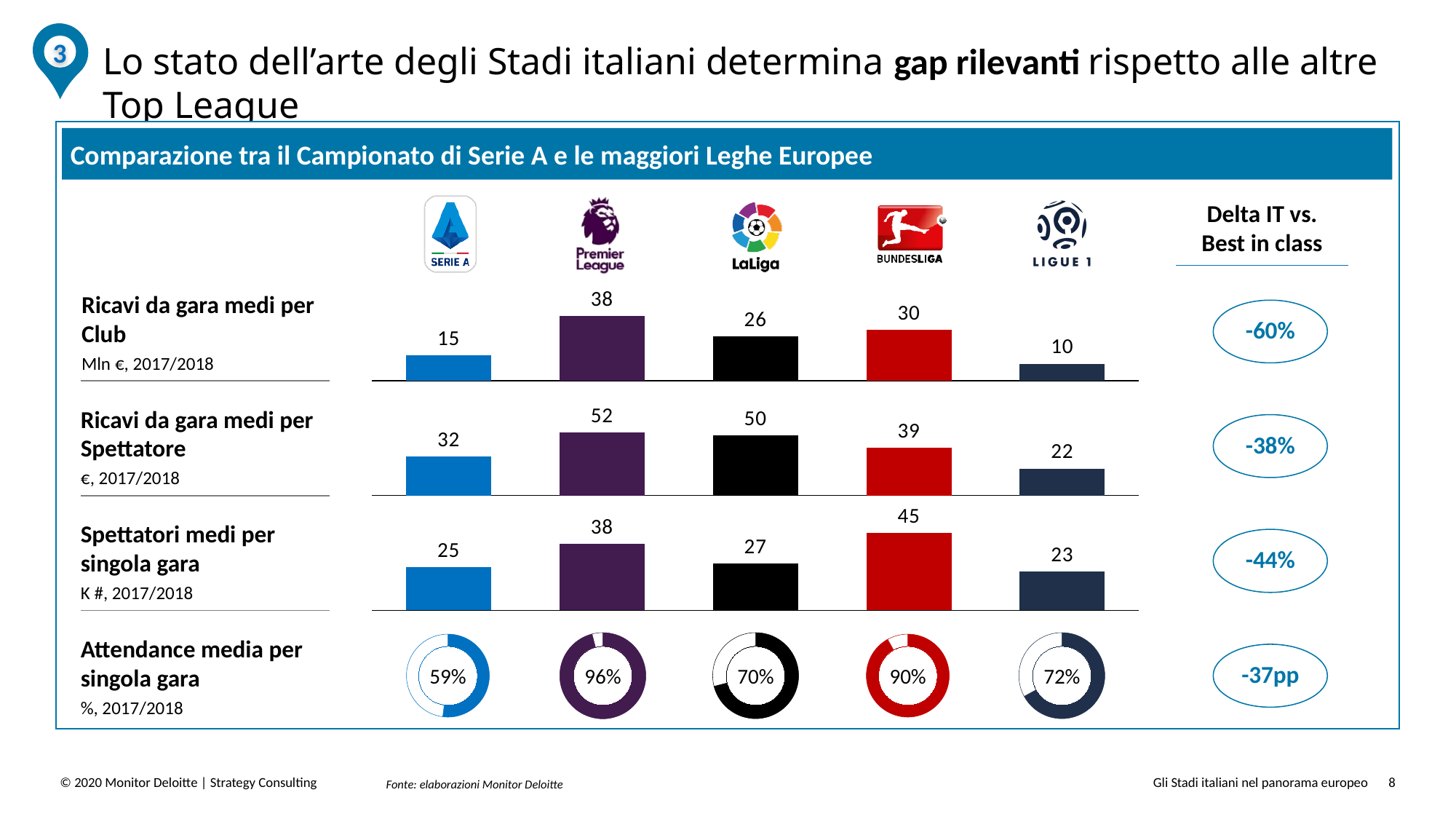
In the 'Ricavi da gara medi per Spettatore' chart, which league has the highest value? Premier League In the 'Ricavi da gara medi per Spettatore' chart, what is the value for Serie A? 32 In the 'Ricavi da gara medi per Club' chart, what is the value for Premier League? 38 In the 'Attendance media per singola gara' chart, what is the value for Bundesliga? 90% How many leagues are compared in the 'Ricavi da gara medi per Club' chart? 5 In the 'Attendance media per singola gara' chart, which league has the lowest attendance? Serie A In the 'Ricavi da gara medi per Club' chart, which league has the lowest value? Ligue 1 In the 'Spettatori medi per singola gara' chart, which is larger, Serie A or Ligue 1? Serie A In the 'Ricavi da gara medi per Spettatore' chart, what is the difference between Premier League and Serie A? 20 In the 'Spettatori medi per singola gara' chart, what is the value for LaLiga? 27 In the 'Spettatori medi per singola gara' chart, which league has the highest value? Bundesliga What kind of chart is used for the 'Ricavi da gara medi per Club' row? Bar chart